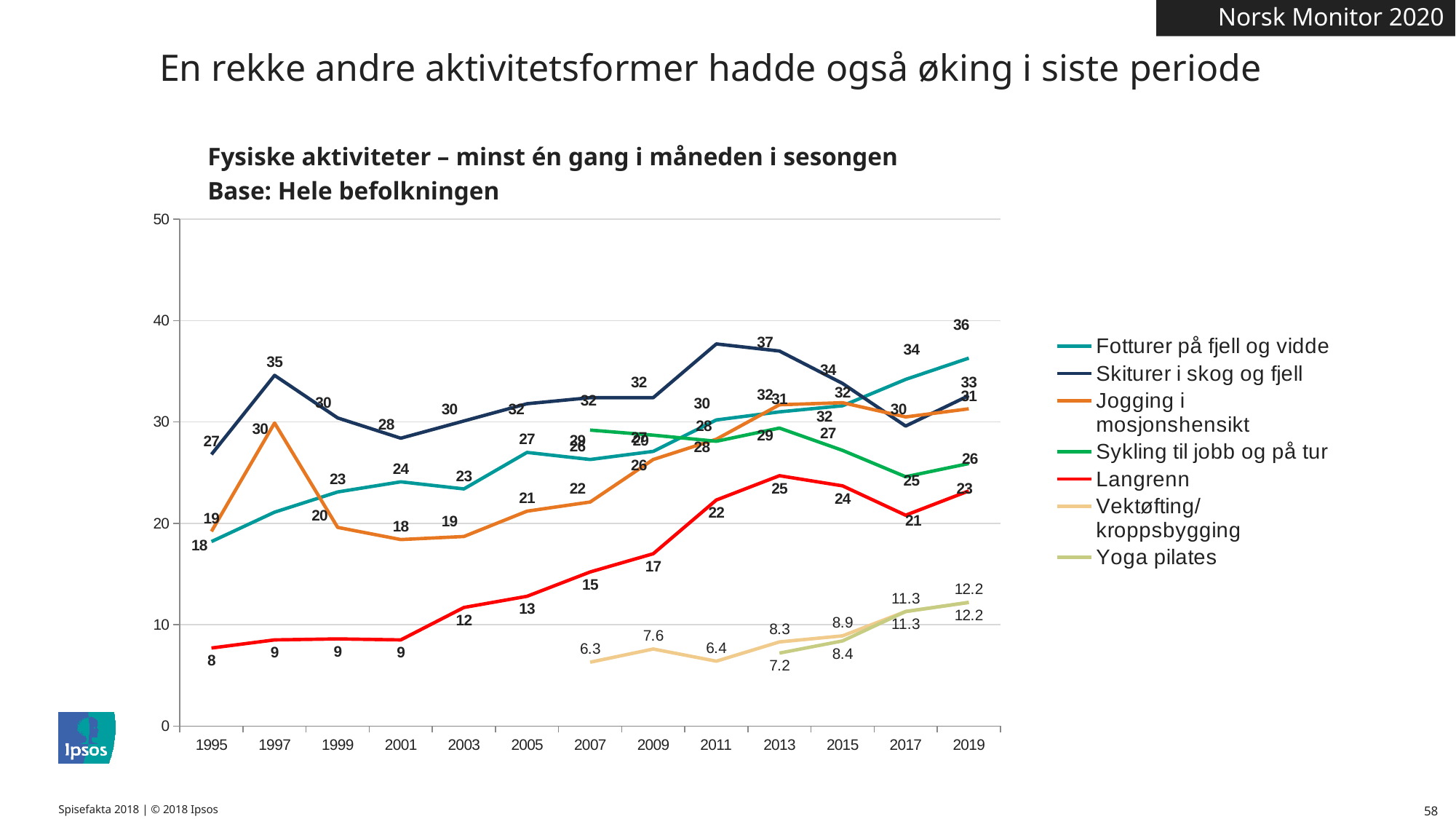
Which is larger in 2013: Langrenn or Sykling til jobb og på tur? Sykling til jobb og på tur In which year is Skiturer i skog og fjell at its lowest value? 1995 Does the value for Fotturer på fjell og vidde generally rise or fall from 1995 to 2019? Rise In which year does Langrenn reach its highest value? 2013 How many series does the legend list? 7 What is the value for Yoga pilates in 2013? 7.2 What type of chart is shown on the slide? Line chart What is the value for Skiturer i skog og fjell in 1997? 35 How many years are shown on the x axis? 13 What is the value for Langrenn in 1995? 8 What is the value for Vektløfting/kroppsbygging in 2007? 6.3 What is the difference between Fotturer på fjell og vidde and Skiturer i skog og fjell in 2019? 3